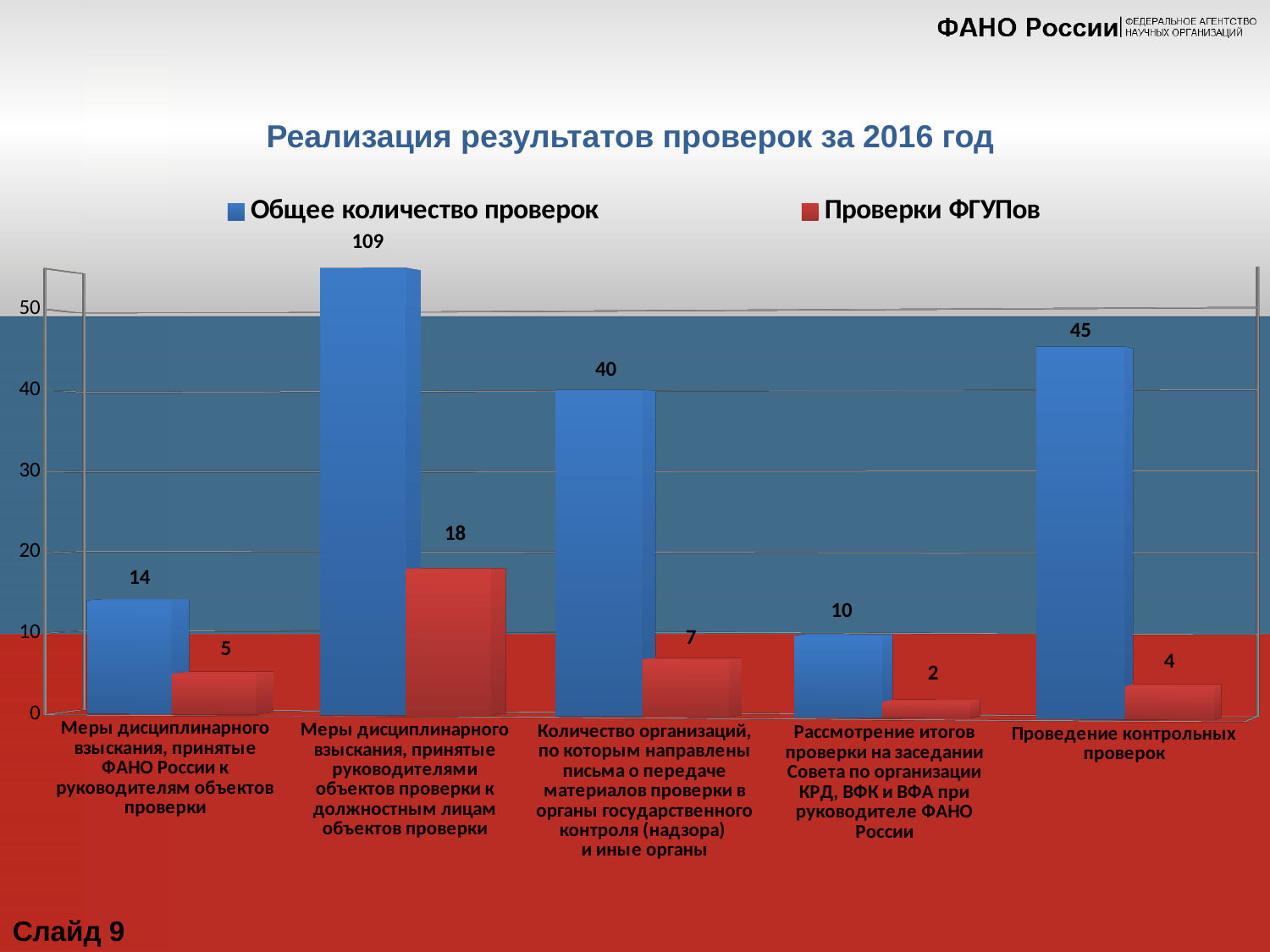
Which category has the highest value for "Общее количество проверок"? Меры дисциплинарного взыскания, принятые руководителями объектов проверки к должностным лицам объектов проверки What is the value of "Проверки ФГУПов" for "Рассмотрение итогов проверки на заседании Совета по организации КРД, ВФК и ВФА при руководителе ФАНО России"? 2 What is the difference between "Общее количество проверок" and "Проверки ФГУПов" for "Количество организаций, по которым направлены письма о передаче материалов проверки в органы государственного контроля (надзора) и иные органы"? 33 What kind of chart is shown on the slide? Bar chart What is the title of the chart? Реализация результатов проверок за 2016 год Which colour represents the series "Проверки ФГУПов"? Red How many categories are shown on the x axis? 5 What is the value of "Проверки ФГУПов" for "Меры дисциплинарного взыскания, принятые руководителями объектов проверки к должностным лицам объектов проверки"? 18 Which is larger: "Общее количество проверок" for "Проведение контрольных проверок" or for "Количество организаций, по которым направлены письма о передаче материалов проверки в органы государственного контроля (надзора) и иные органы"? Проведение контрольных проверок How many series does the legend list? 2 What is the value of "Общее количество проверок" for "Проведение контрольных проверок"? 45 Which category has the lowest value for "Проверки ФГУПов"? Рассмотрение итогов проверки на заседании Совета по организации КРД, ВФК и ВФА при руководителе ФАНО России